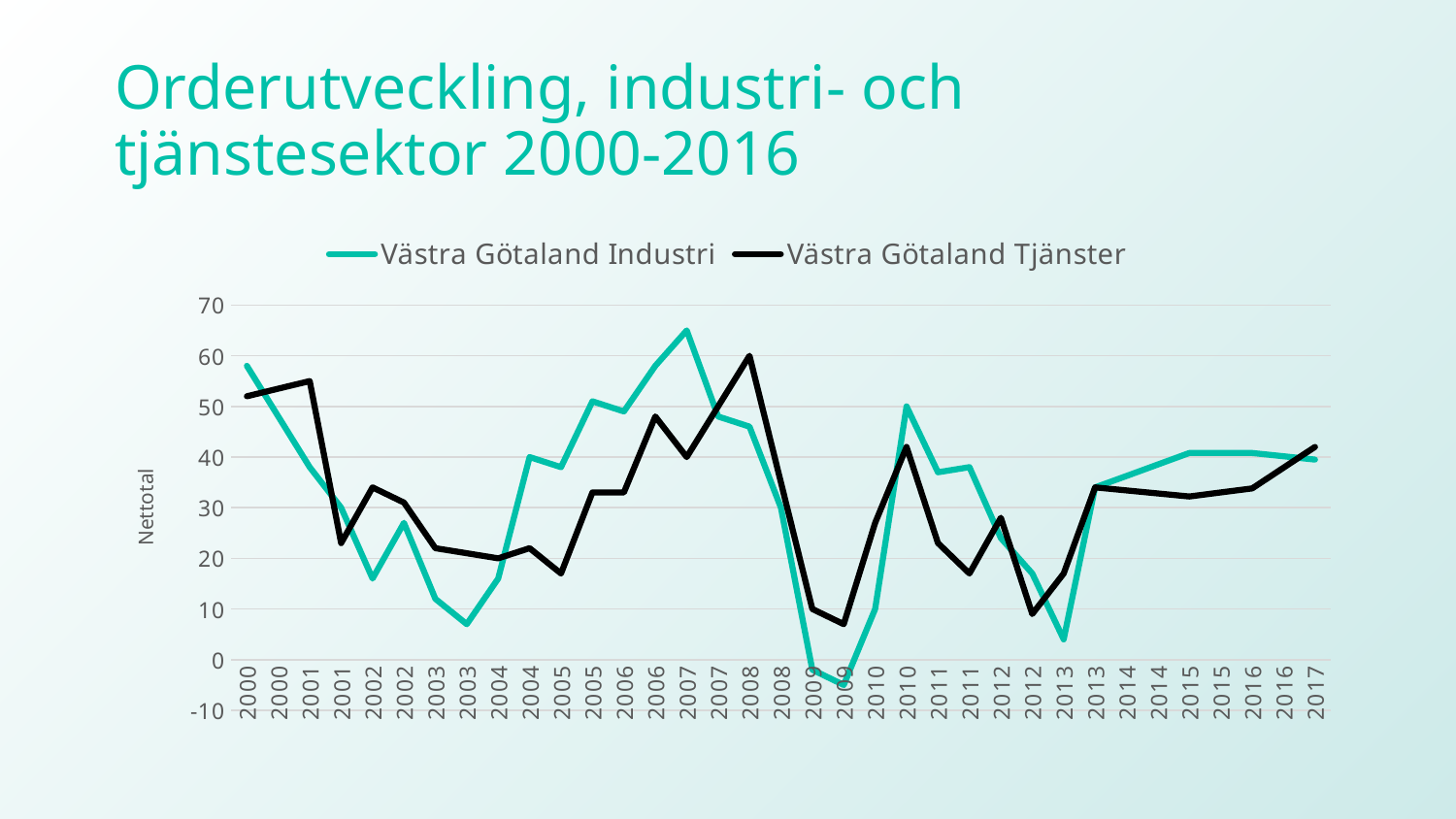
At the second 2008 point, which series has the higher value, Västra Götaland Industri or Västra Götaland Tjänster? Västra Götaland Tjänster How many series does the legend list? 2 Is the value for Västra Götaland Tjänster at the second 2008 point greater or less than 50? less Is the value for Västra Götaland Industri at the first 2009 point greater or less than 0? less Is the value for Västra Götaland Industri at the first 2007 point greater or less than 60? greater What kind of chart is shown on the slide? line chart In which year does the Västra Götaland Industri series reach its highest value? 2007 Do both series rise or fall between 2008 and 2009? fall What is the label on the vertical axis? Nettotal What are the two series named in the legend? Västra Götaland Industri and Västra Götaland Tjänster At the first 2007 point, which series has the higher value, Västra Götaland Industri or Västra Götaland Tjänster? Västra Götaland Industri